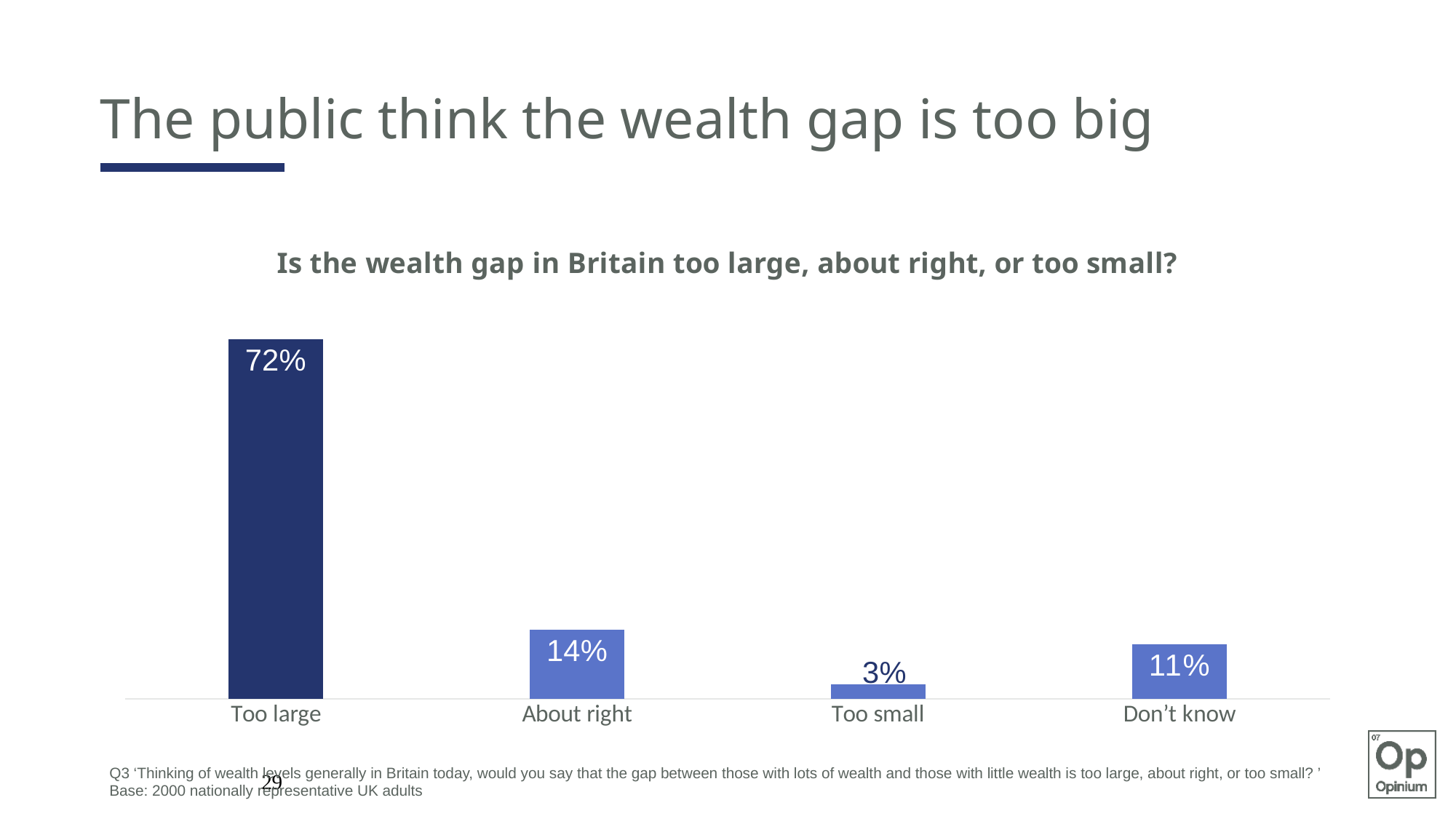
How many response categories are shown in the chart? 4 What is the difference in percentage points between 'About right' and 'Don't know'? 3 What percentage of respondents said the wealth gap is too large? 72% What type of chart is shown on the slide? Bar chart Which response category has the highest value? Too large What is the title of the chart? Is the wealth gap in Britain too large, about right, or too small? What is the difference in percentage points between 'Too large' and 'About right'? 58 What percentage of respondents answered 'Don't know'? 11% What percentage of respondents said the wealth gap is about right? 14% What percentage of respondents said the wealth gap is too small? 3% Which response category has the lowest value? Too small Which is larger, the value for 'About right' or the value for 'Don't know'? About right